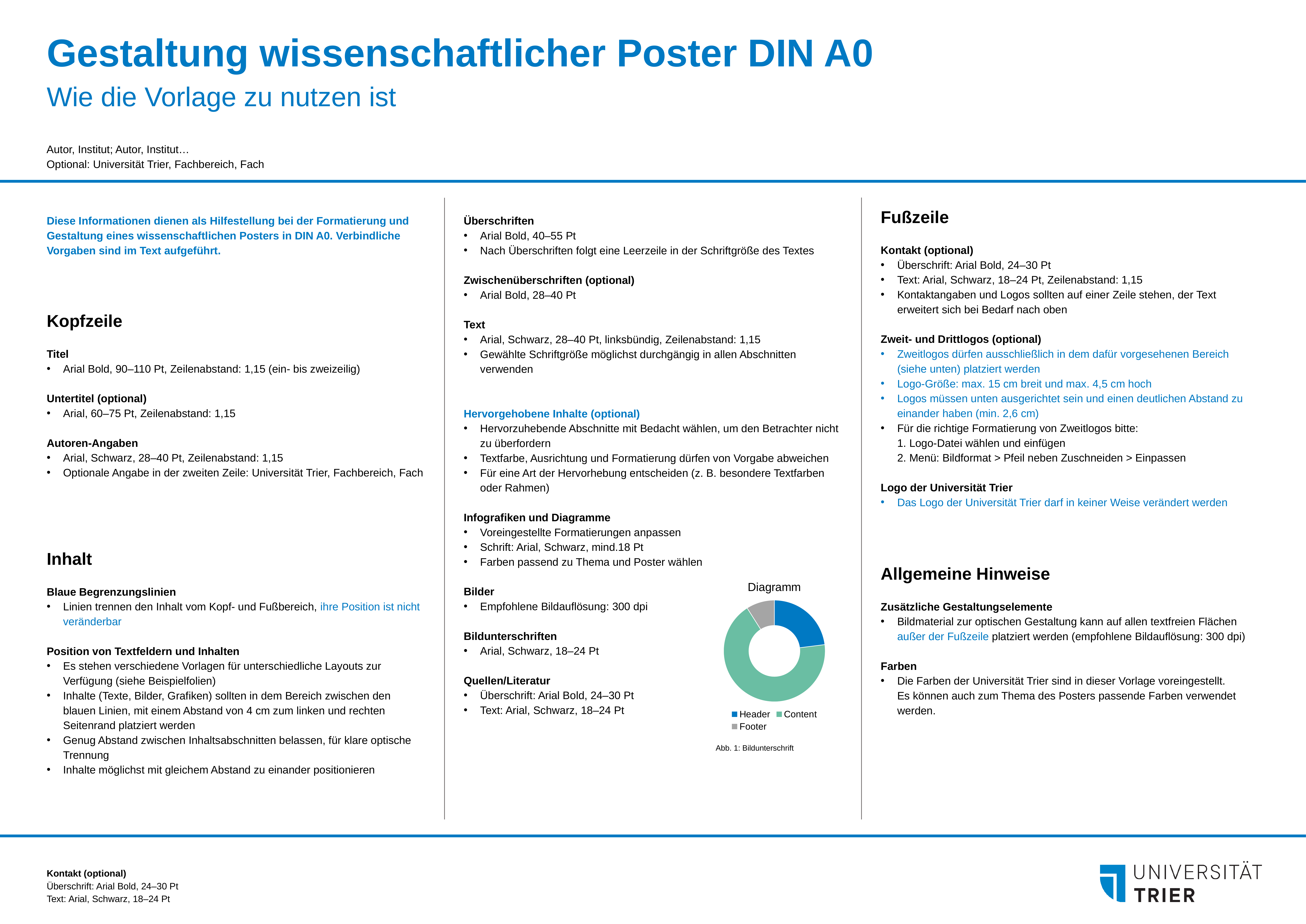
In the "Diagramm" chart, which slice is larger: Header or Footer? Header How many slices does the "Diagramm" doughnut chart have? 3 In the "Diagramm" chart, which slice is larger: Header or Content? Content What is the title of the chart on the slide? Diagramm Which category takes the largest share of the "Diagramm" chart? Content Which entries does the legend of the "Diagramm" chart list? Header, Content, Footer What kind of chart is shown under the heading "Diagramm"? doughnut chart Which category takes the smallest share of the "Diagramm" chart? Footer